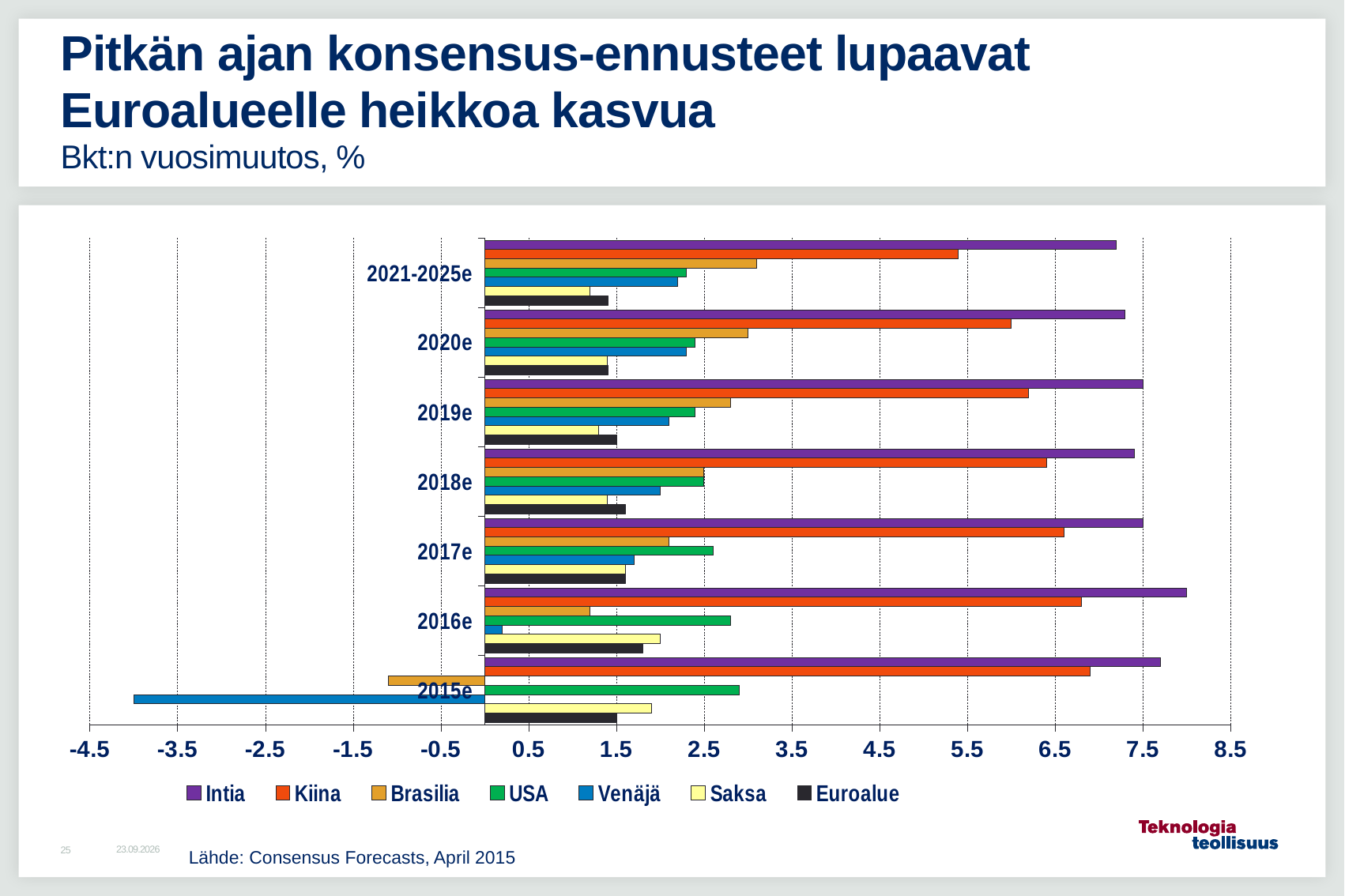
How many time-period categories are shown on the vertical axis? 7 Is the value for Venäjä in 2015e greater or less than -3.5? less Which series is shown in black in the legend? Euroalue Is the value for Kiina in 2021-2025e greater or less than 6.5? less Which country has the lowest value for 2015e? Venäjä Does the value for Kiina rise or fall from 2015e to 2021-2025e? fall Is the value for Brasilia in 2015e greater or less than 0.5? less Which country has the highest value for 2015e? Intia How many series does the legend list? 7 What kind of chart is shown on the slide? bar chart For 2016e, which is larger, the value for Intia or the value for Kiina? Intia